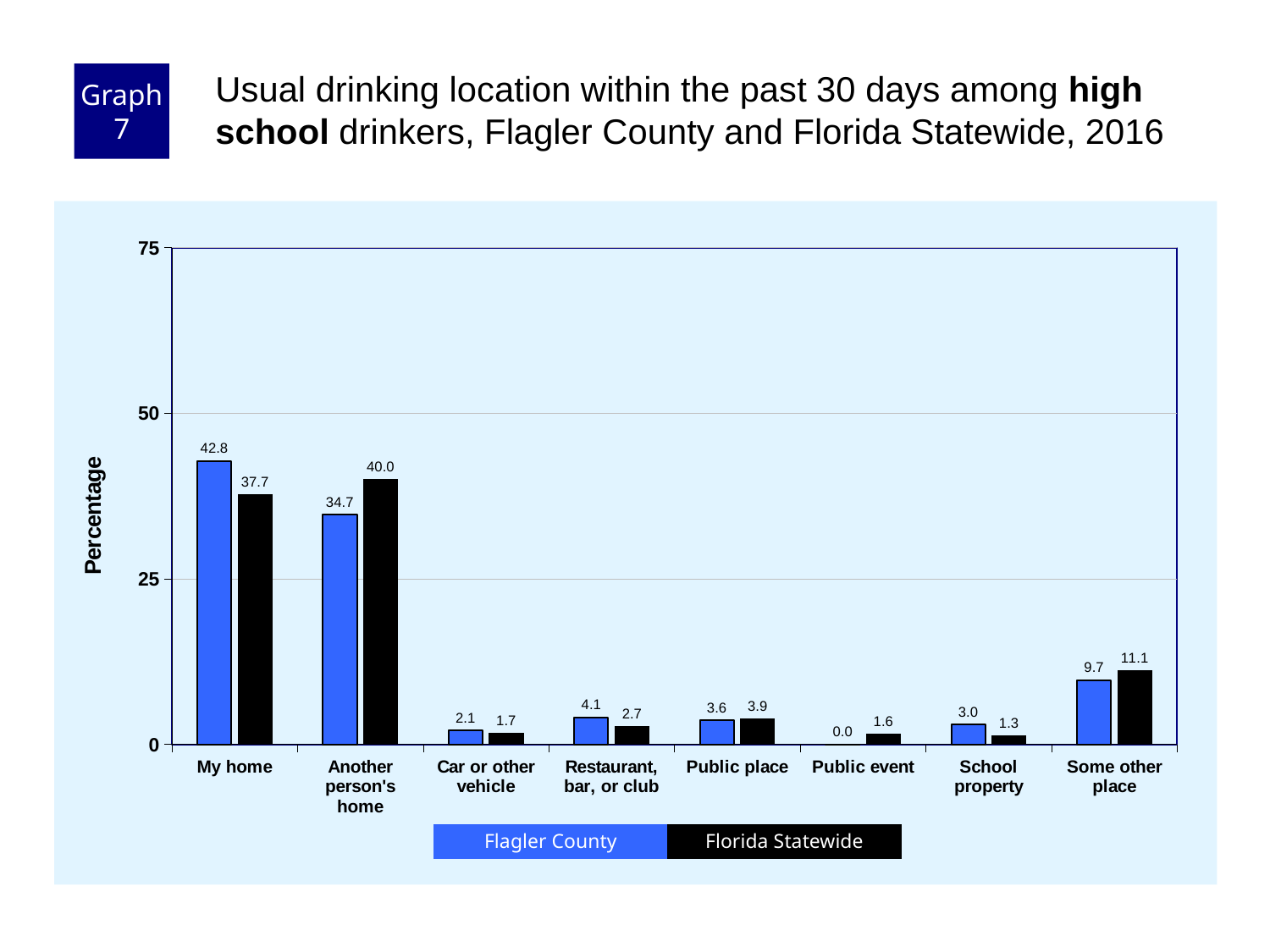
How many location categories are shown on the x axis? 8 What is the Flagler County value for Public event? 0.0 What kind of chart is shown? bar chart How many series does the legend list? 2 What is the label of the y axis? Percentage Which category has the lowest Florida Statewide value? School property Is the Florida Statewide value for Another person's home greater or less than 25? greater Which is larger for Some other place, Flagler County or Florida Statewide? Florida Statewide Which category has the highest Flagler County value? My home What is the Florida Statewide value for Another person's home? 40.0 What is the difference between the Flagler County and Florida Statewide values for My home? 5.1 What is the Flagler County value for My home? 42.8